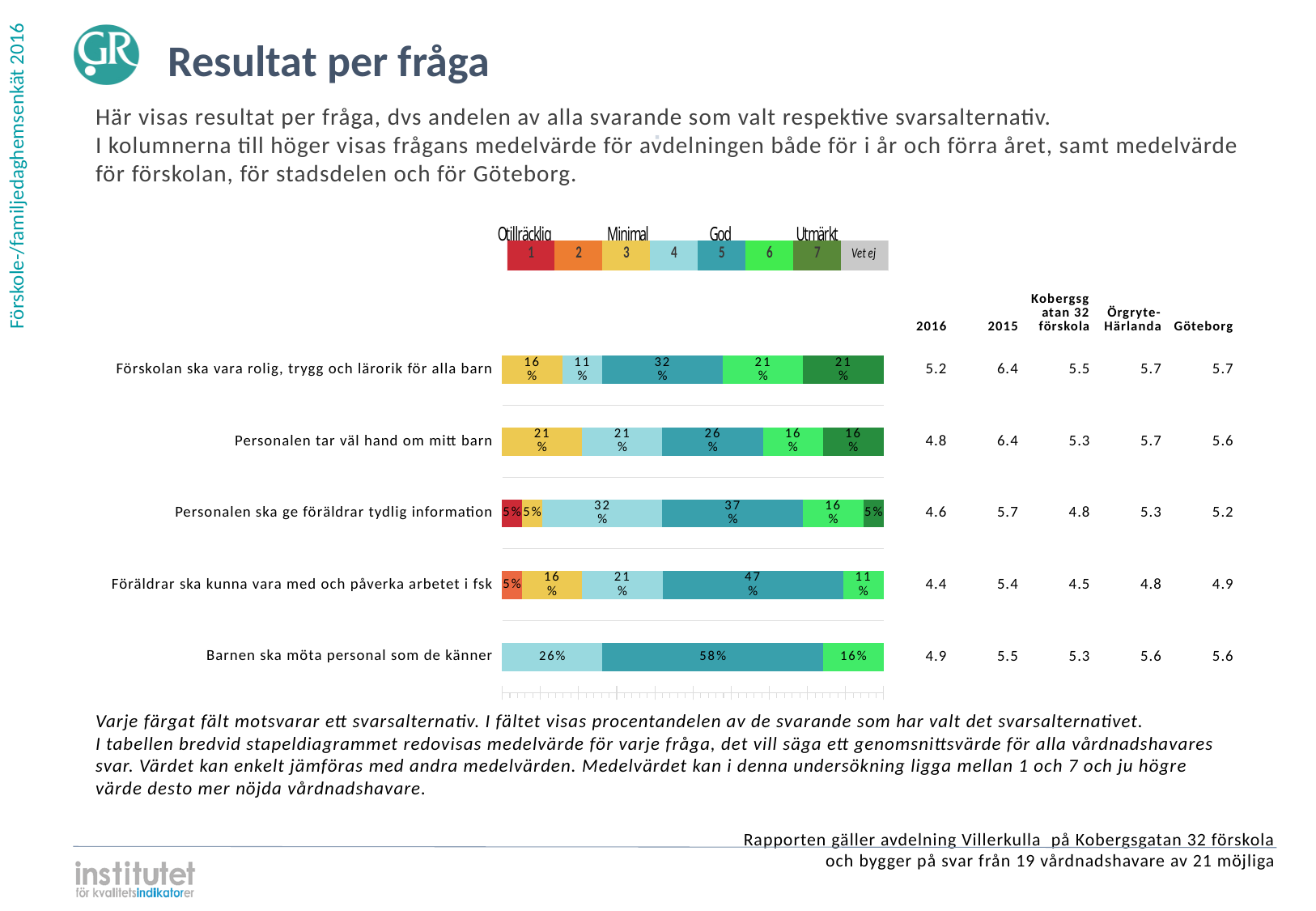
How many answer alternatives does the legend above the chart list? 8 What percentage of respondents chose answer 5 (God) for 'Barnen ska möta personal som de känner'? 58% What kind of chart is shown on the slide? stacked bar chart Which answer alternative has the largest share for 'Personalen ska ge föräldrar tydlig information'? 5 (37%) How many questions (categories) are plotted in the bar chart? 5 What percentage chose answer 5 for 'Föräldrar ska kunna vara med och påverka arbetet i fsk'? 47% Which question has the highest 2016 mean value in the table? Förskolan ska vara rolig, trygg och lärorik för alla barn (5.2) What percentage chose answer 7 for 'Förskolan ska vara rolig, trygg och lärorik för alla barn'? 21% For 'Barnen ska möta personal som de känner', which is larger: the share for answer 4 or the share for answer 6? answer 4 (26%) What is the 2016 mean value for 'Föräldrar ska kunna vara med och påverka arbetet i fsk'? 4.4 What is the difference between the share for answer 5 and the share for answer 4 in 'Personalen tar väl hand om mitt barn'? 5% What is the total of the three segments in the bar for 'Barnen ska möta personal som de känner'? 100%